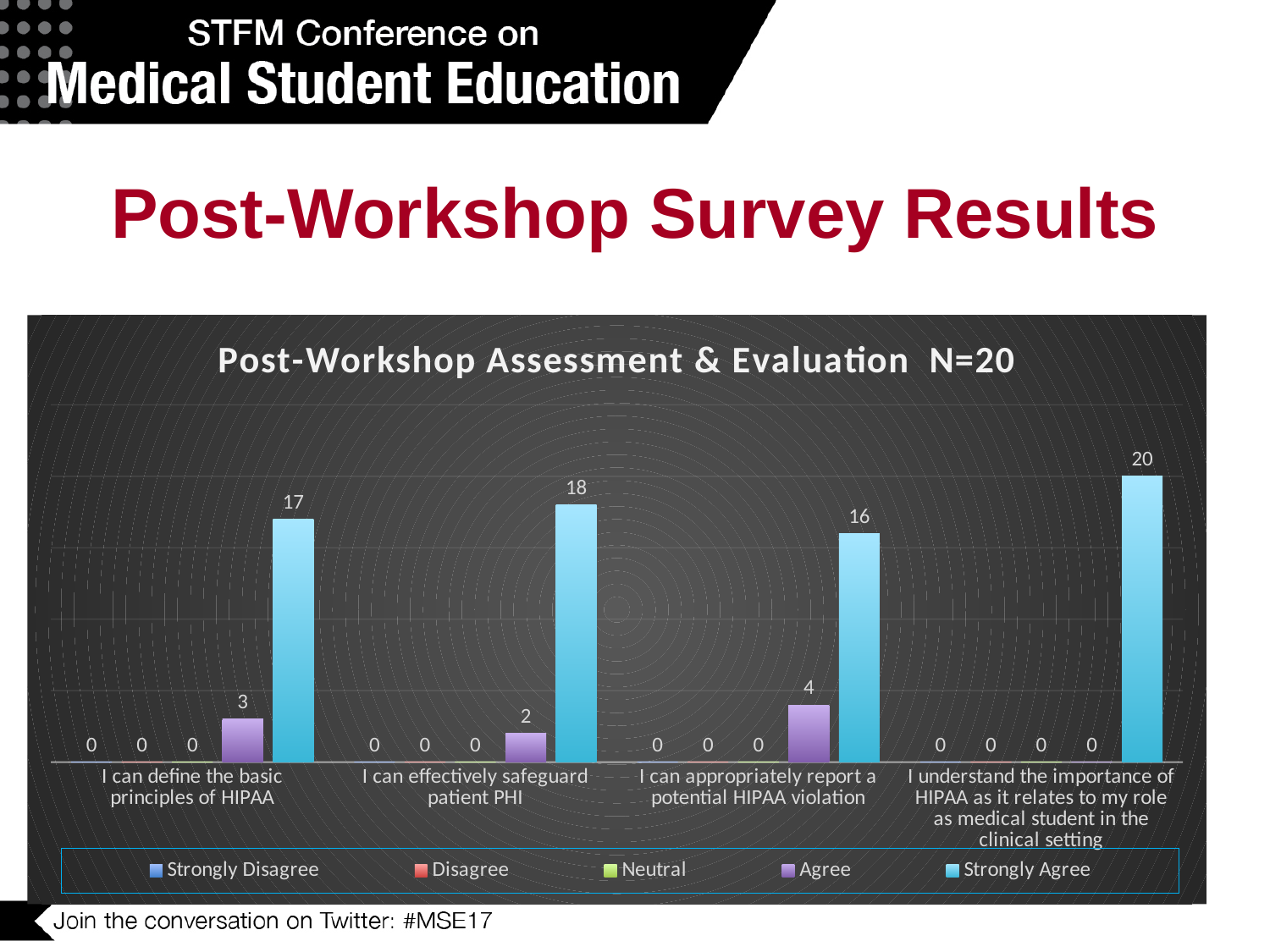
How many categories are shown on the x axis? 4 What kind of chart is shown on the slide? Bar chart What is the Strongly Agree value for "I can define the basic principles of HIPAA"? 17 What is the Agree value for "I can appropriately report a potential HIPAA violation"? 4 What is the difference between the Strongly Agree values for "I can effectively safeguard patient PHI" and "I can appropriately report a potential HIPAA violation"? 2 What is the title of the chart? Post-Workshop Assessment & Evaluation N=20 Which category has the lowest Strongly Agree value? I can appropriately report a potential HIPAA violation Which category has the highest Strongly Agree value? I understand the importance of HIPAA as it relates to my role as medical student in the clinical setting Which is larger: the Agree value for "I can define the basic principles of HIPAA" or the Agree value for "I can effectively safeguard patient PHI"? I can define the basic principles of HIPAA What is the Strongly Agree value for "I can appropriately report a potential HIPAA violation"? 16 What is the Agree value for "I can effectively safeguard patient PHI"? 2 How many series does the legend list? 5